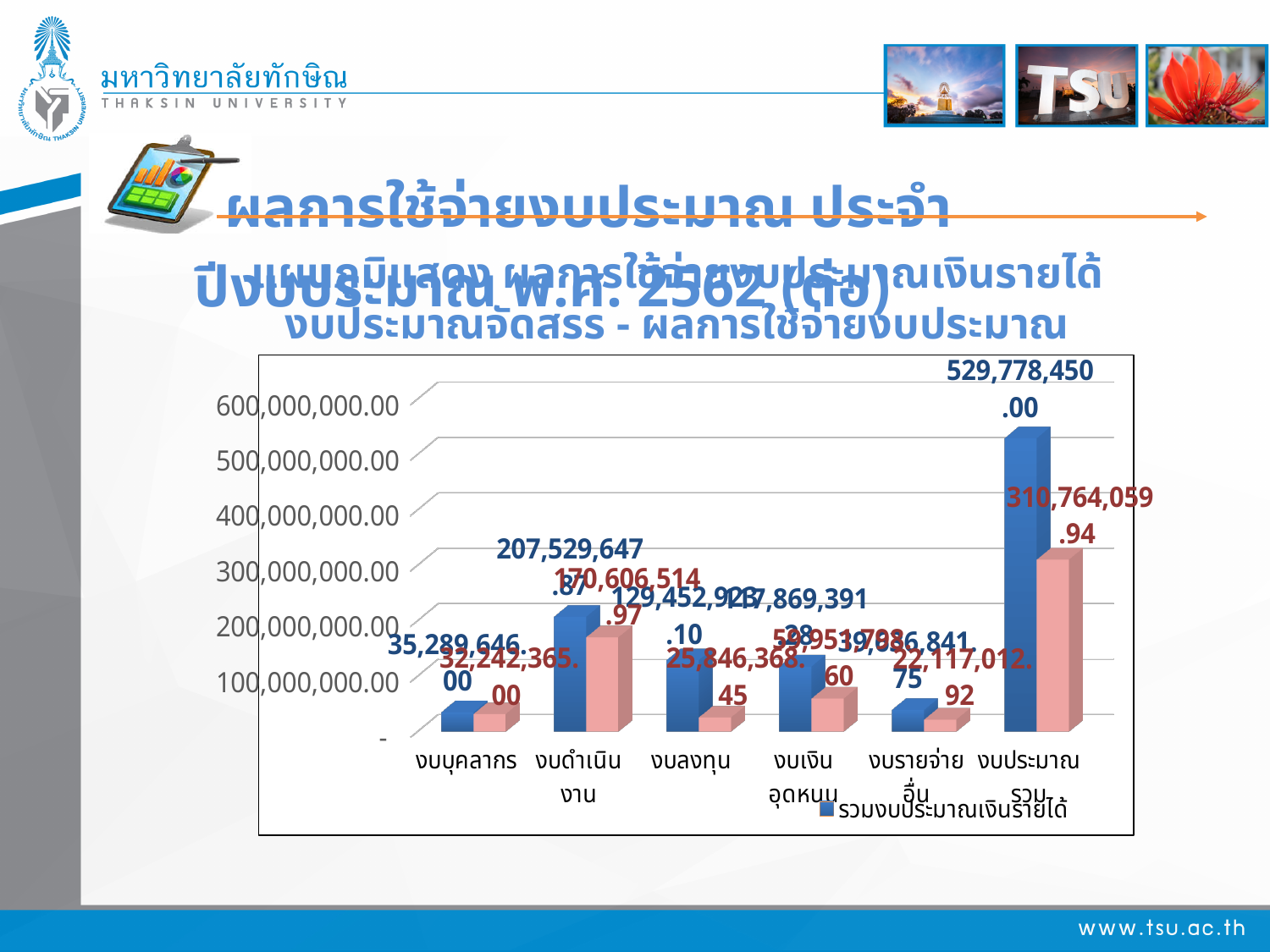
What is the difference between the blue and pink bars for งบประมาณรวม? 219,014,390.06 For งบลงทุน, which bar is larger, the blue one or the pink one? The blue one Is the value of the blue bar for งบดำเนินงาน greater or less than 200,000,000.00? greater What is the value of the blue bar for งบดำเนินงาน? 207,529,647.87 What type of chart is shown on the slide? Bar chart What is the value of the pink bar for งบประมาณรวม? 310,764,059.94 What is the value of the blue bar for งบประมาณรวม? 529,778,450.00 How many categories are shown on the x axis of the chart? 6 Which category has the highest blue bar? งบประมาณรวม What is the value of the pink bar for งบลงทุน? 25,846,368.45 Which category has the lowest blue bar? งบบุคลากร What is the value of the pink bar for งบบุคลากร? 32,242,365.00